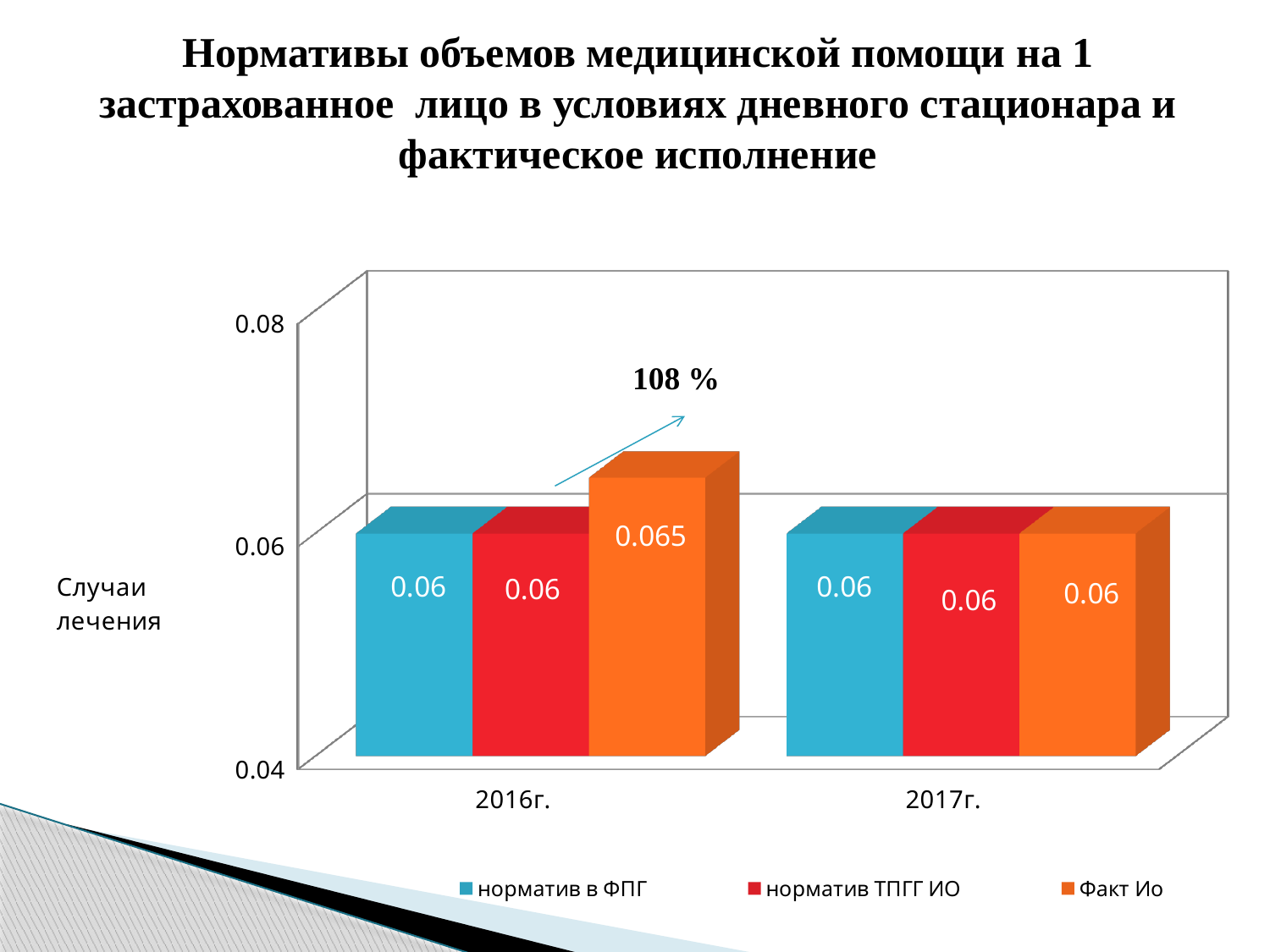
What percentage is written in the annotation above the 2016г. bars? 108 % What is the value of Факт Ио for 2016г.? 0.065 What is the value of норматив в ФПГ for 2017г.? 0.06 Which series has the highest value in 2016г.? Факт Ио What is the value of Факт Ио for 2017г.? 0.06 Which is larger: Факт Ио in 2016г. or Факт Ио in 2017г.? Факт Ио in 2016г. How many series does the legend list? 3 How many year categories are shown on the x axis? 2 What kind of chart is shown on the slide? bar chart What is the difference between Факт Ио and норматив в ФПГ in 2016г.? 0.005 What is the value of норматив ТПГГ ИО for 2016г.? 0.06 Is the value of Факт Ио for 2016г. greater or less than 0.08? less